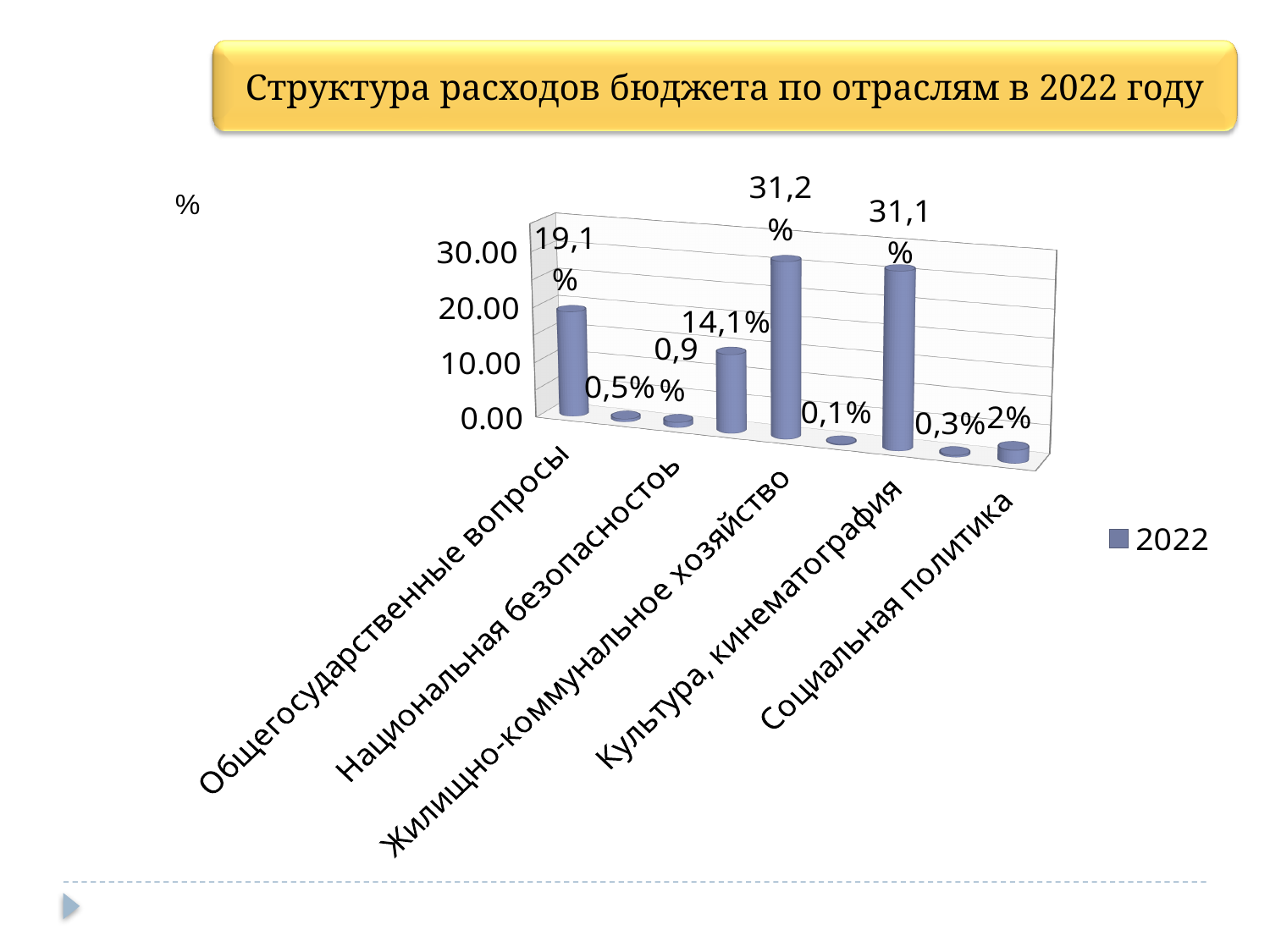
What is the value for Культура, кинематография? 31,1% Which of the labelled categories has the highest value? Жилищно-коммунальное хозяйство How many series does the legend list? 1 Which is larger, the value for Общегосударственные вопросы or the value for Жилищно-коммунальное хозяйство? Жилищно-коммунальное хозяйство What is the difference between the values for Жилищно-коммунальное хозяйство and Общегосударственные вопросы? 12,1% What is the value for Социальная политика? 2% What kind of chart is shown on the slide? bar chart What is the value for Жилищно-коммунальное хозяйство? 31,2% What is the title of the chart? Структура расходов бюджета по отраслям в 2022 году How many bars are plotted in the chart? 9 What is the value for Общегосударственные вопросы? 19,1% What series name is shown in the legend? 2022